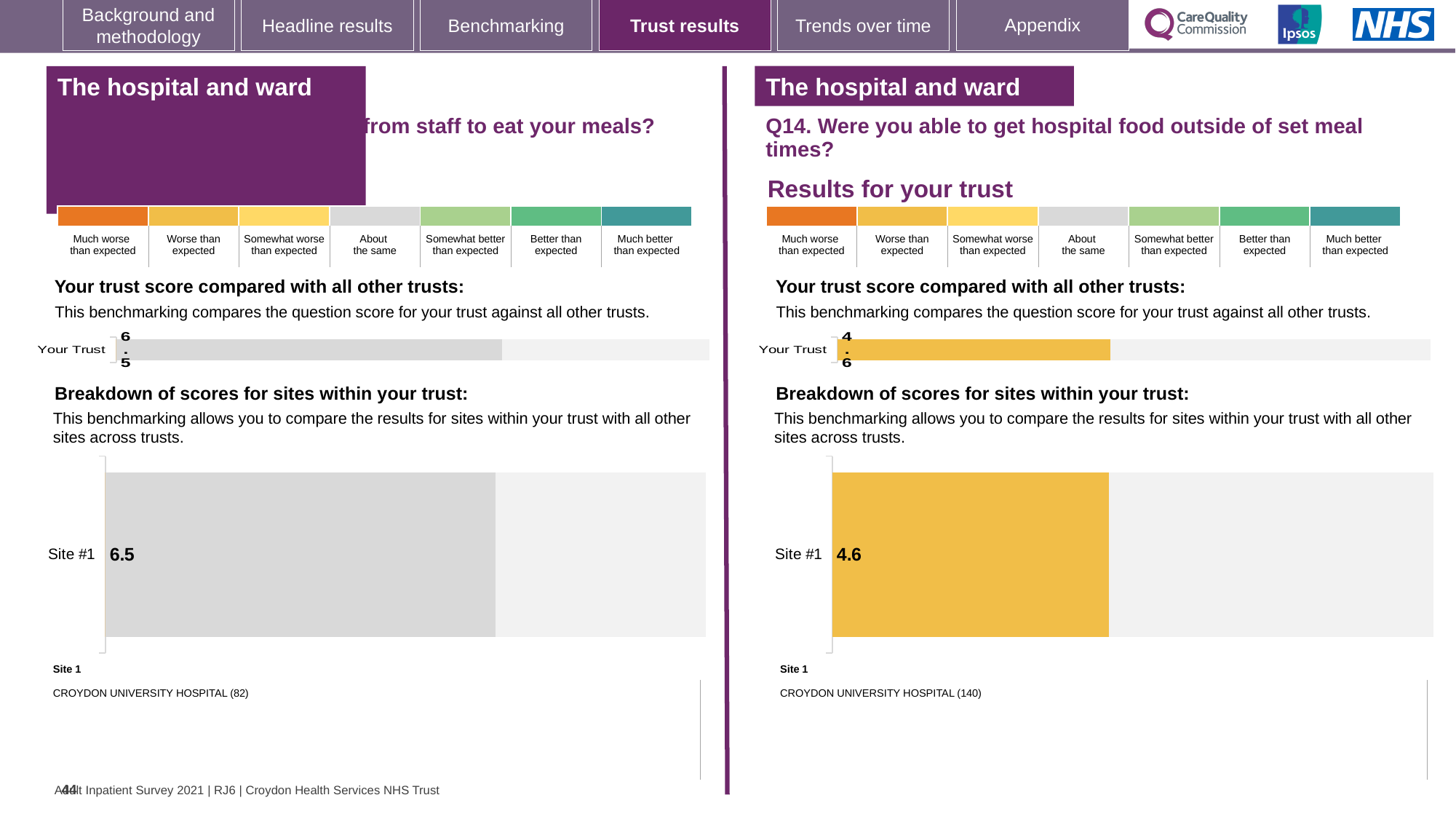
On the left-hand side of the slide, what is the trust score shown in the 'Your trust score compared with all other trusts' chart? 6.5 On the right-hand side of the slide (Q14), what score is shown for Site #1 in the breakdown of scores chart? 4.6 On the left-hand side of the slide, what score is shown for Site #1 in the breakdown of scores chart? 6.5 On the right-hand side (Q14), which site is listed as Site 1 below the chart? CROYDON UNIVERSITY HOSPITAL (140) On the right-hand side (Q14), which benchmark category does the colour of the Site #1 bar correspond to in the key? Worse than expected What type of chart is used to show the Site #1 score on the right-hand side (Q14)? Bar chart Which is larger: the Site #1 score on the left-hand chart or the Site #1 score on the right-hand (Q14) chart? Left-hand chart (6.5) On the left-hand side, which benchmark category does the colour of the Site #1 bar correspond to in the key? About the same What is the difference between the Site #1 score on the left-hand chart (6.5) and the Site #1 score on the right-hand Q14 chart (4.6)? 1.9 On the right-hand side of the slide (Q14), what is the trust score shown in the 'Your trust score compared with all other trusts' chart? 4.6 How many sites are shown in the breakdown of scores chart on the right-hand side (Q14)? 1 On the left-hand side, which site is listed as Site 1 below the chart? CROYDON UNIVERSITY HOSPITAL (82)